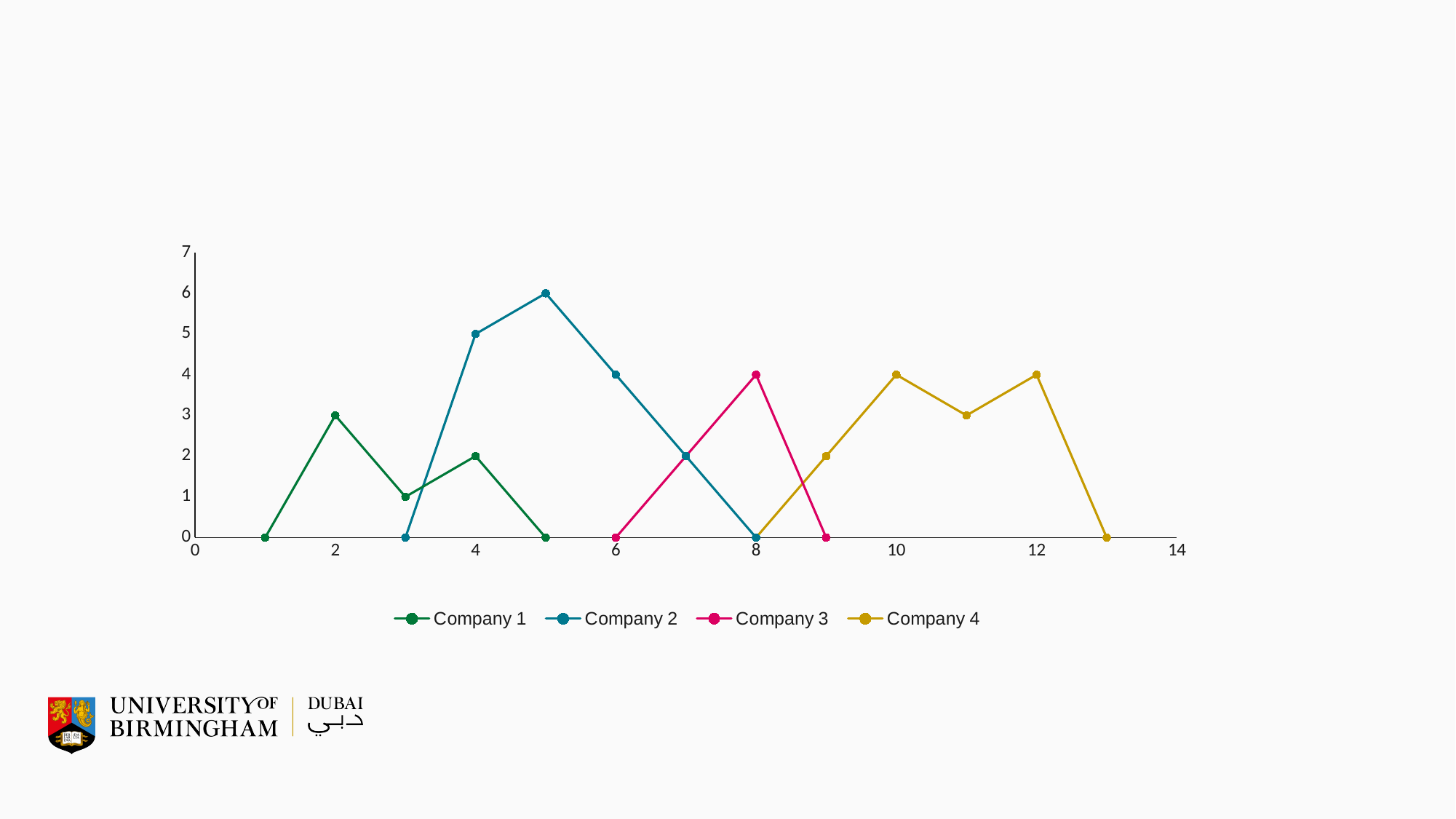
What is the value of Company 2 at x = 4? 5 What is the value of Company 1 at x = 2? 3 Which company's line reaches the highest value on the chart? Company 2 What is the difference between the peak value of Company 2 and the peak value of Company 1? 3 What is the value of Company 4 at x = 10? 4 At x = 4, which is larger, the value for Company 1 or the value for Company 2? Company 2 What is the highest value reached by Company 2? 6 What kind of chart is shown on the slide? line chart What is the value of Company 3 at x = 8? 4 How many data points are plotted for Company 3? 4 How many series does the legend list? 4 Does the Company 2 line rise or fall between x = 6 and x = 8? fall